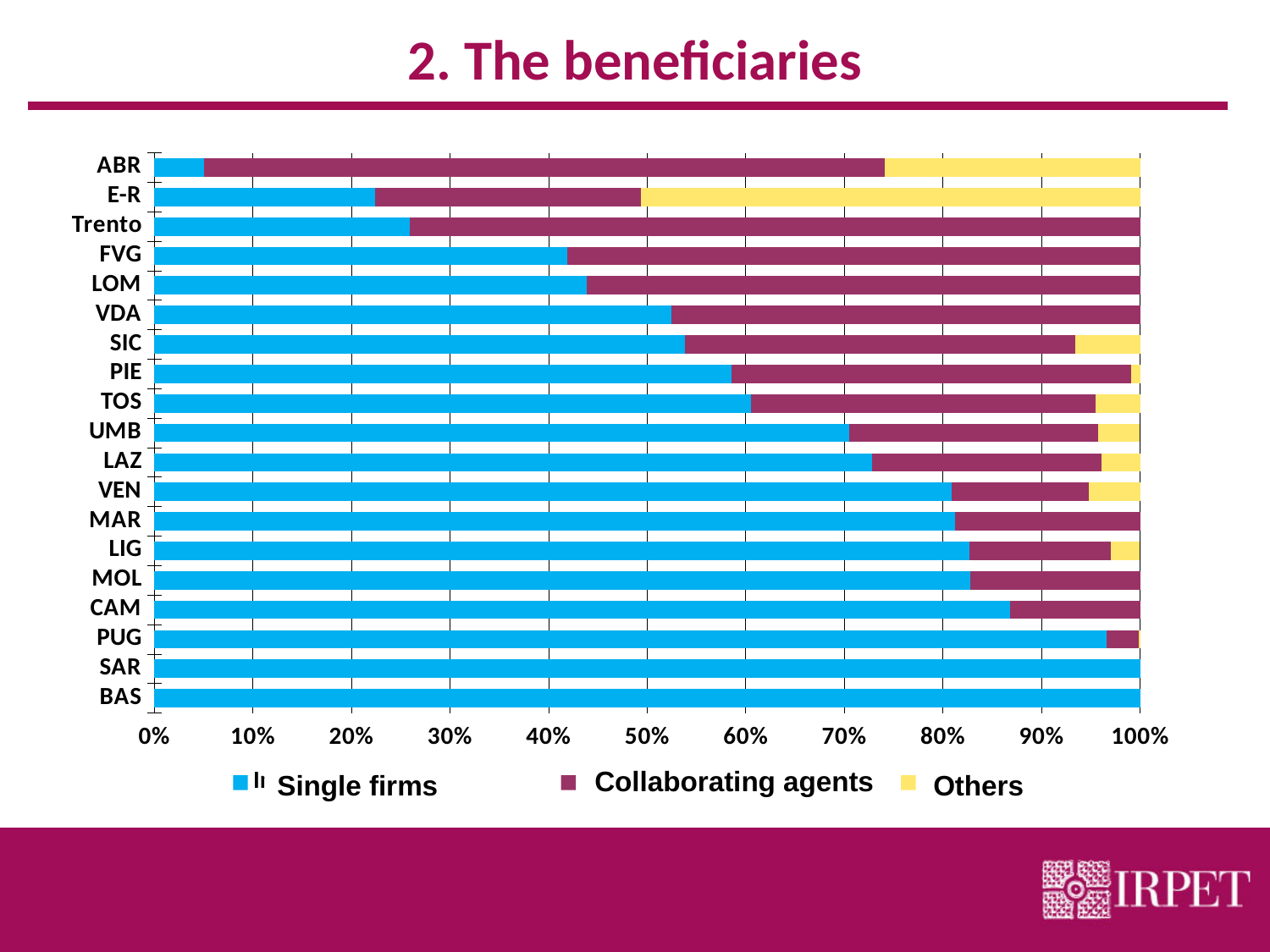
Which region has the highest share of Others? E-R How many regions (categories) are listed on the vertical axis of the chart? 19 How many series does the chart legend list? 3 Which has a larger Single firms share, E-R or FVG? FVG Is the Single firms share for Trento greater or less than 30%? less What is the Single firms share for BAS? 100% Is the Single firms share for LAZ greater or less than 70%? greater Is the Single firms share for ABR greater or less than 10%? less Which series is shown in yellow in the chart? Others What kind of chart is shown on the slide? Stacked bar chart Which region has the lowest share of Single firms? ABR